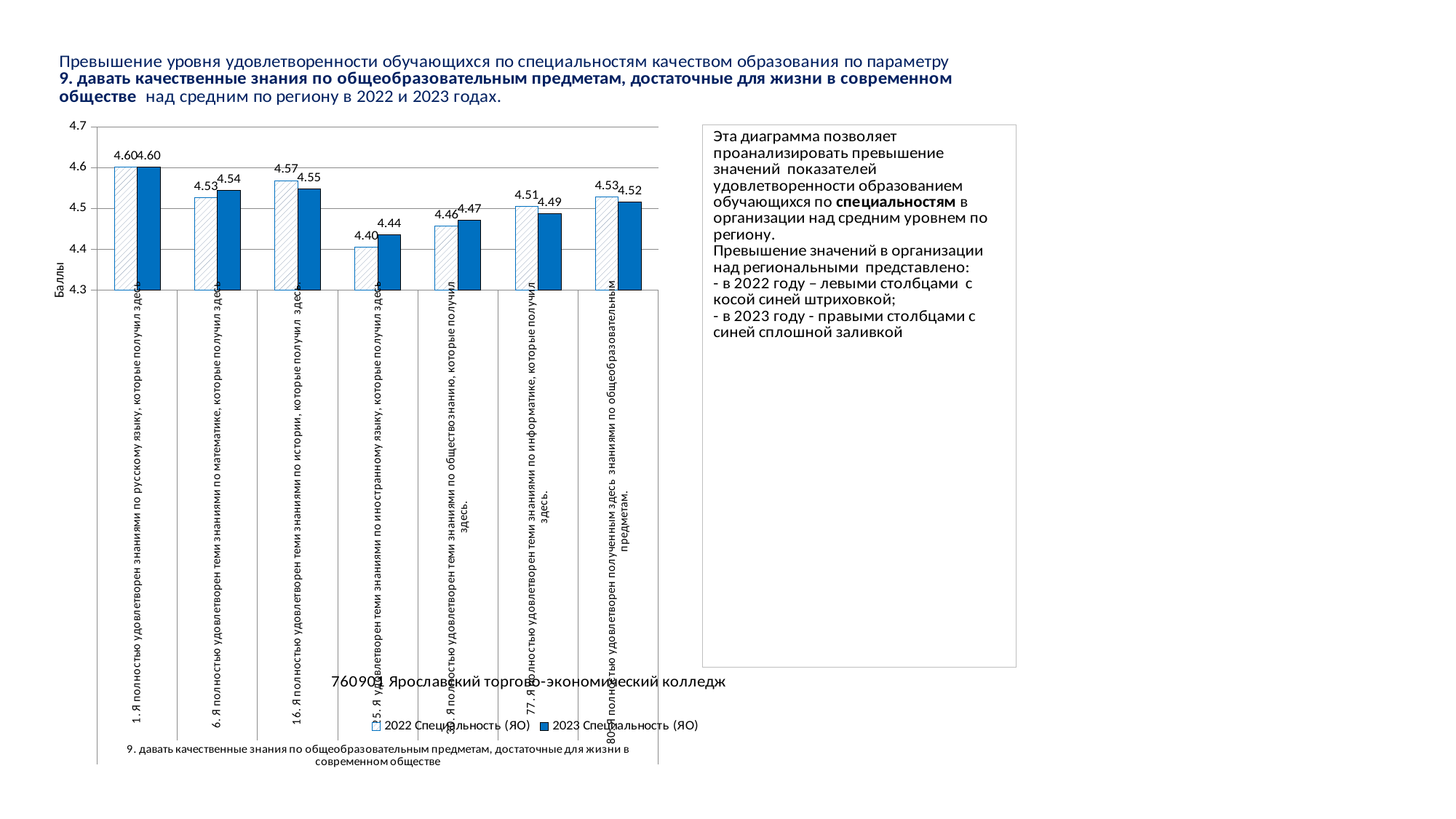
Which statement has the lowest 2022 Специальность (ЯО) value? 25. Я удовлетворен теми знаниями по иностранному языку, которые получил здесь How many categories (statements) are plotted on the x axis of the chart? 7 For the statement about informatics (77. ...по информатике...), which is larger: the 2022 Специальность (ЯО) value or the 2023 Специальность (ЯО) value? 2022 Специальность (ЯО) What is the 2022 Специальность (ЯО) value for the statement about knowledge of Russian language (1. Я полностью удовлетворен теми знаниями по русскому языку...)? 4.60 How many series does the chart legend list? 2 What is the difference between the 2023 and 2022 Специальность (ЯО) values for the statement about foreign language (25. ...по иностранному языку...)? 0.04 What type of chart is shown on the slide? bar chart Which statement has the highest 2023 Специальность (ЯО) value? 1. Я полностью удовлетворен знаниями по русскому языку, которые получил здесь What is the 2023 Специальность (ЯО) value for the statement about social studies (30. ...по обществознанию...)? 4.47 What is the 2023 Специальность (ЯО) value for the statement about knowledge of mathematics (6. Я полностью удовлетворен теми знаниями по математике...)? 4.54 What is the 2022 Специальность (ЯО) value for the statement about knowledge of history (16. Я полностью удовлетворен теми знаниями по истории...)? 4.57 What is the label of the vertical axis of the chart? Баллы